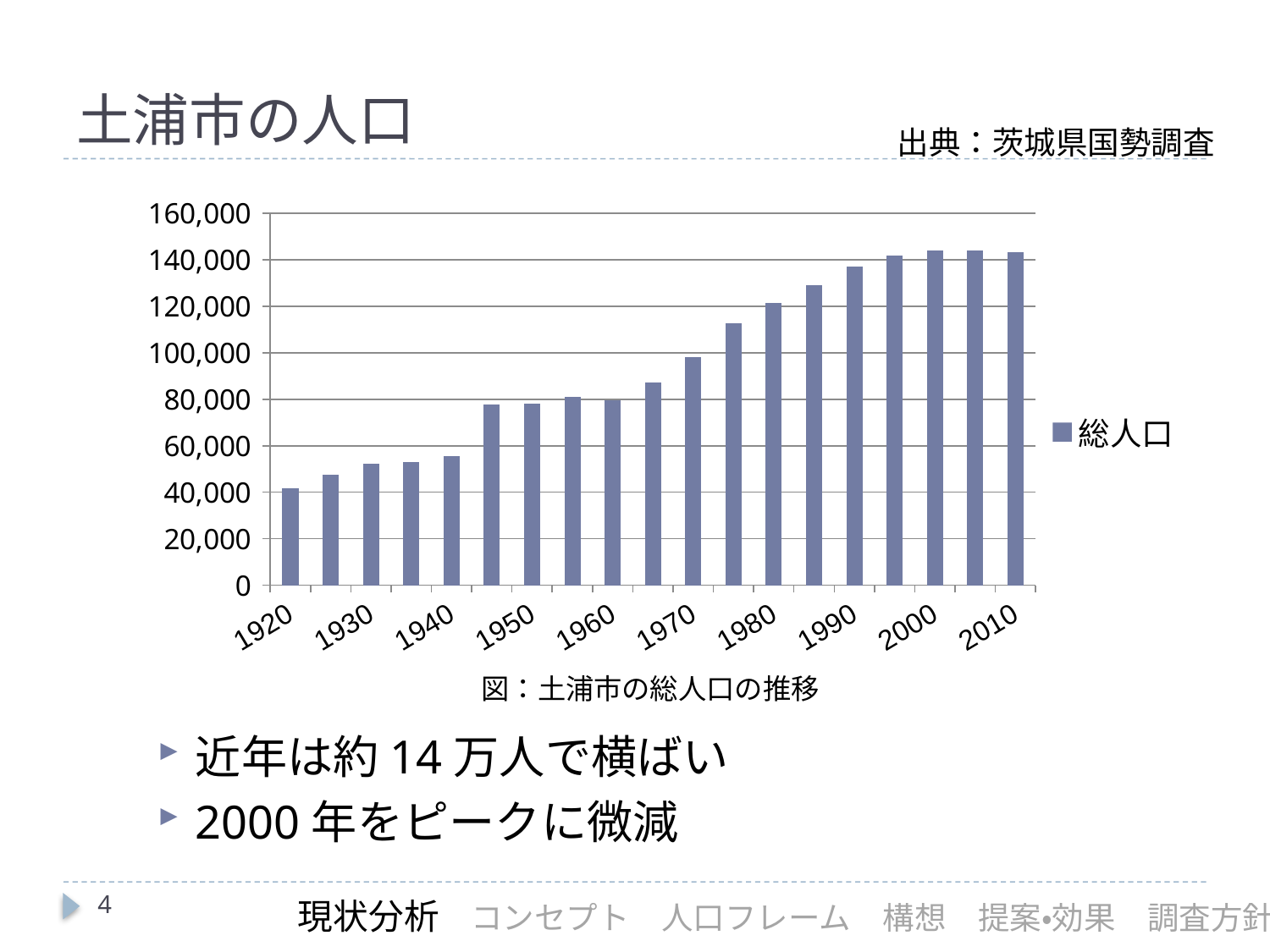
What kind of chart is shown on the slide? bar chart Is the value for 1920 greater or less than 60,000? less Is the value for 1990 greater or less than 120,000? greater What is the name of the series shown in the legend? 総人口 Which is larger, the value for 1970 or the value for 1990? 1990 How many bars are plotted in the chart? 19 Which labelled year has the lowest population bar? 1920 Do the values generally rise or fall from 1920 to 2000? rise How many series does the legend list? 1 Is the value for 1930 greater or less than 60,000? less What is the caption printed below the chart? 図：土浦市の総人口の推移